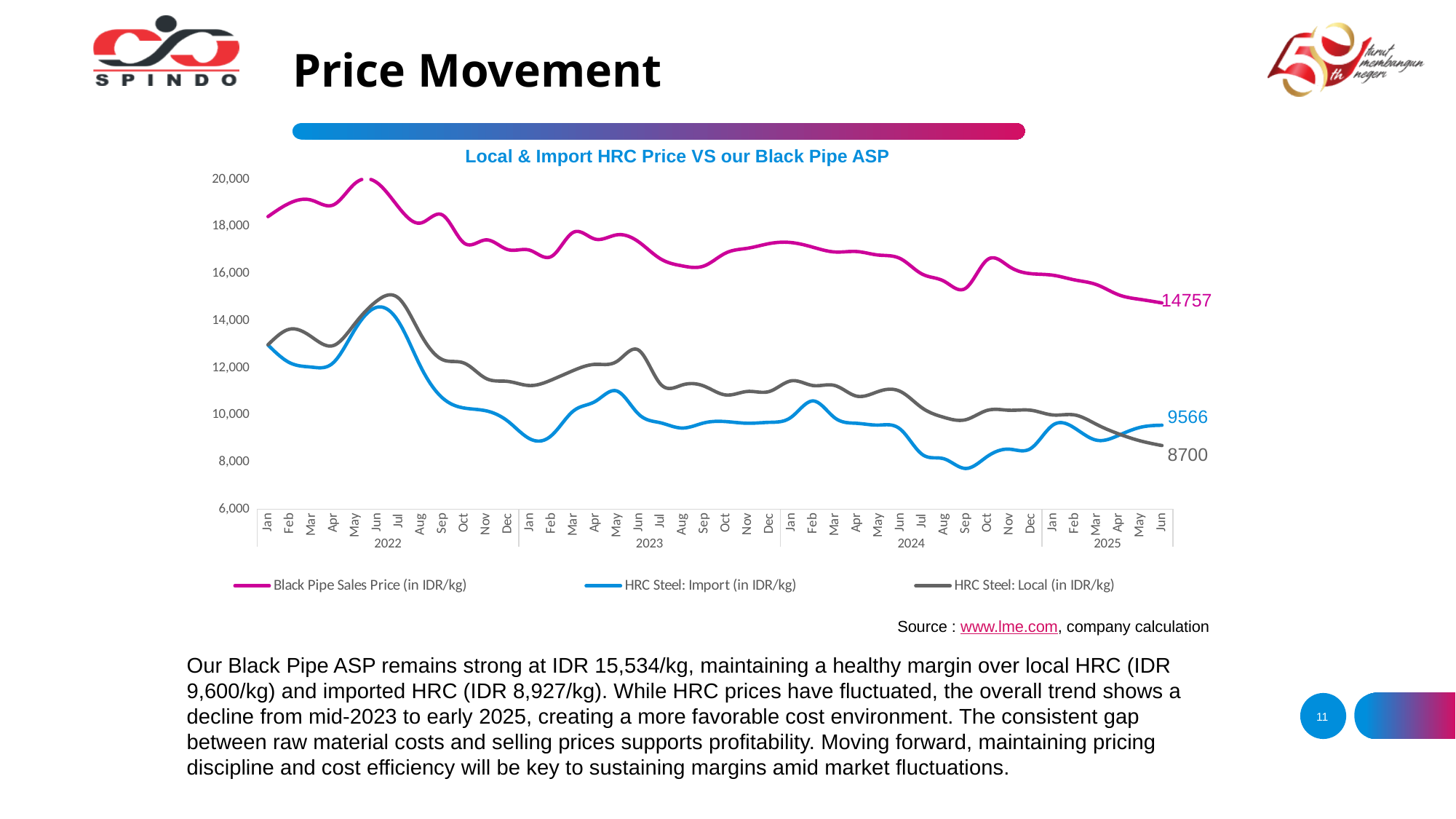
Does the Black Pipe Sales Price overall rise or fall from Jan 2022 to Jun 2025? Fall Which series has the highest value in Jun 2025? Black Pipe Sales Price (in IDR/kg) Is the Black Pipe Sales Price in Sep 2024 greater or less than 16,000? less What is the difference between the HRC Steel: Import and HRC Steel: Local labelled values in Jun 2025? 866 In Jun 2025, which is larger: HRC Steel: Import or HRC Steel: Local? HRC Steel: Import What is the HRC Steel: Local price (in IDR/kg) labelled at the end of the line in Jun 2025? 8700 What is the difference between the Black Pipe Sales Price and the HRC Steel: Import price at the labelled Jun 2025 values? 5191 How many series does the legend list? 3 What is the Black Pipe Sales Price (in IDR/kg) shown at the end of the line in Jun 2025? 14757 Is the Black Pipe Sales Price in May 2022 greater or less than 18,000? greater What kind of chart is shown on the slide? Line chart What is the HRC Steel: Import price (in IDR/kg) labelled at the end of the line in Jun 2025? 9566